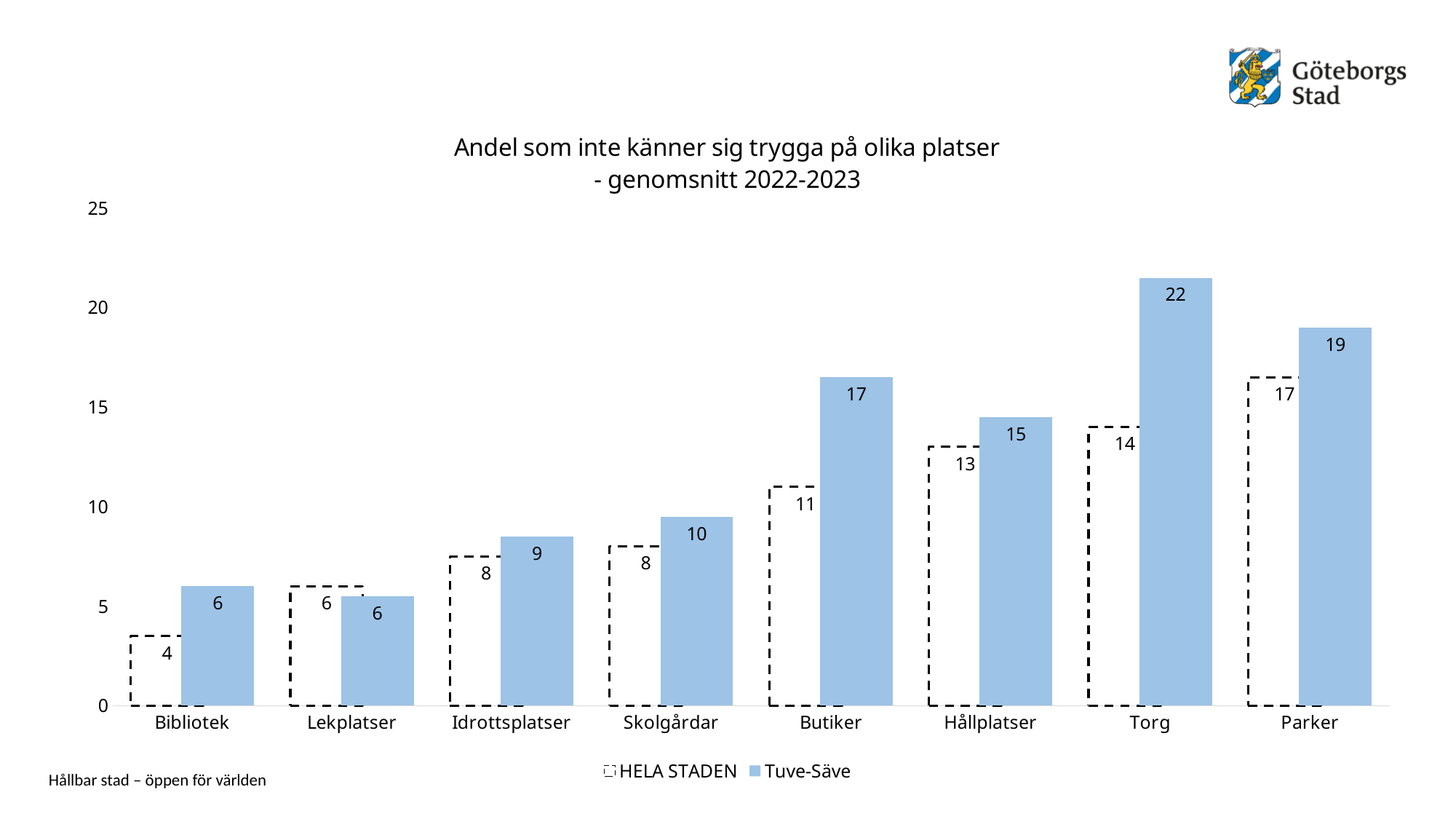
What kind of chart is shown on the slide? Bar chart Which series is drawn with a dashed outline? HELA STADEN How many categories are shown on the x axis? 8 Which category has the highest Tuve-Säve value? Torg Which category has the lowest HELA STADEN value? Bibliotek What is the HELA STADEN value for Butiker? 11 How many series does the legend list? 2 What is the difference between the Tuve-Säve values for Parker and Butiker? 2 What is the difference between the Tuve-Säve and HELA STADEN values for Torg? 8 For Butiker, which is larger: the HELA STADEN value or the Tuve-Säve value? Tuve-Säve What is the Tuve-Säve value for Skolgårdar? 10 What is the Tuve-Säve value for Torg? 22